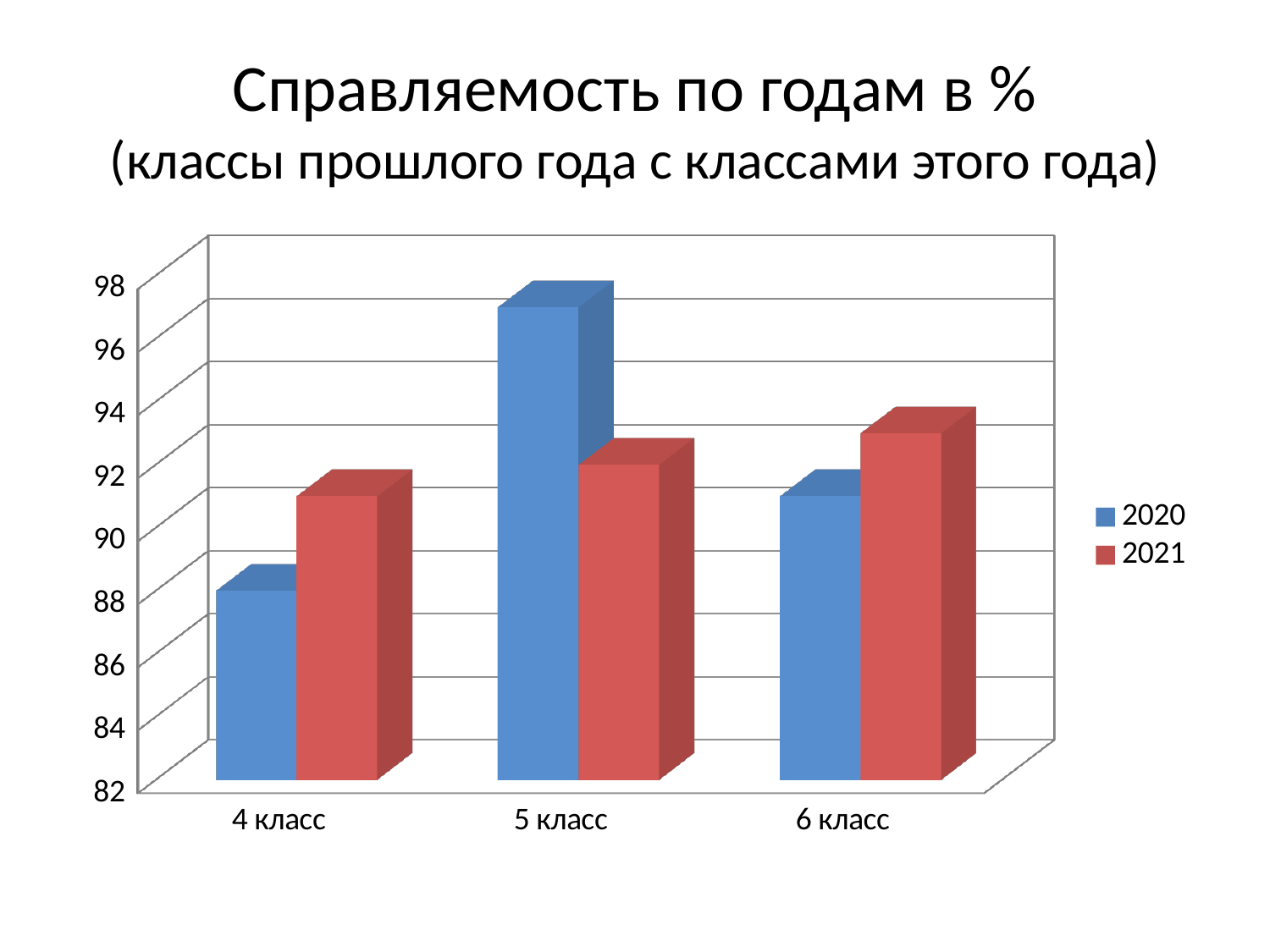
Which class has the highest value for 2020? 5 класс Which colour represents the 2021 series in the legend? red Which class has the highest value for 2021? 6 класс Is the value for 6 класс in 2020 greater or less than 94? less Is the value for 4 класс in 2020 greater or less than 90? less For 4 класс, which year has the larger value, 2020 or 2021? 2021 What kind of chart is shown on the slide? bar chart Is the value for 5 класс in 2020 greater or less than 96? greater How many class categories are shown on the x axis? 3 For 5 класс, which year has the larger value, 2020 or 2021? 2020 Which class has the lowest value for 2020? 4 класс How many series does the legend list? 2